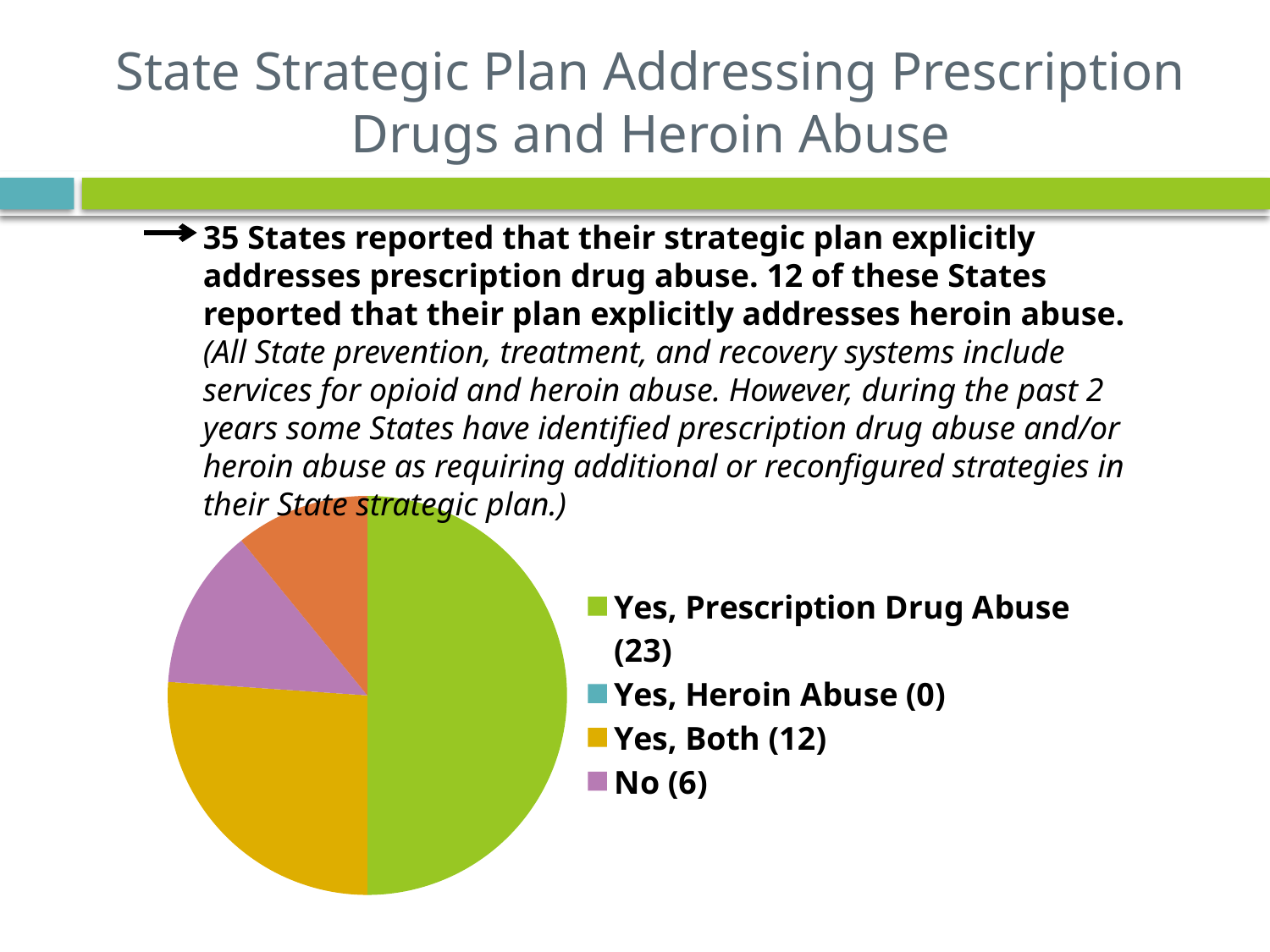
What is the difference between the values for "Yes, Prescription Drug Abuse" and "Yes, Both"? 11 What is the difference between the values for "Yes, Both" and "No"? 6 What value is shown for "Yes, Prescription Drug Abuse" in the pie chart legend? 23 Which legend category has the lowest value in the pie chart? Yes, Heroin Abuse What value is shown for "Yes, Both" in the pie chart legend? 12 Which is larger, the value for "Yes, Both" or the value for "No"? Yes, Both What value is shown for "Yes, Heroin Abuse" in the pie chart legend? 0 What kind of chart is shown on the slide? pie chart What value is shown for "No" in the pie chart legend? 6 What colour is the "Yes, Both" slice in the pie chart? yellow Which legend category has the highest value in the pie chart? Yes, Prescription Drug Abuse How many categories does the pie chart legend list? 4